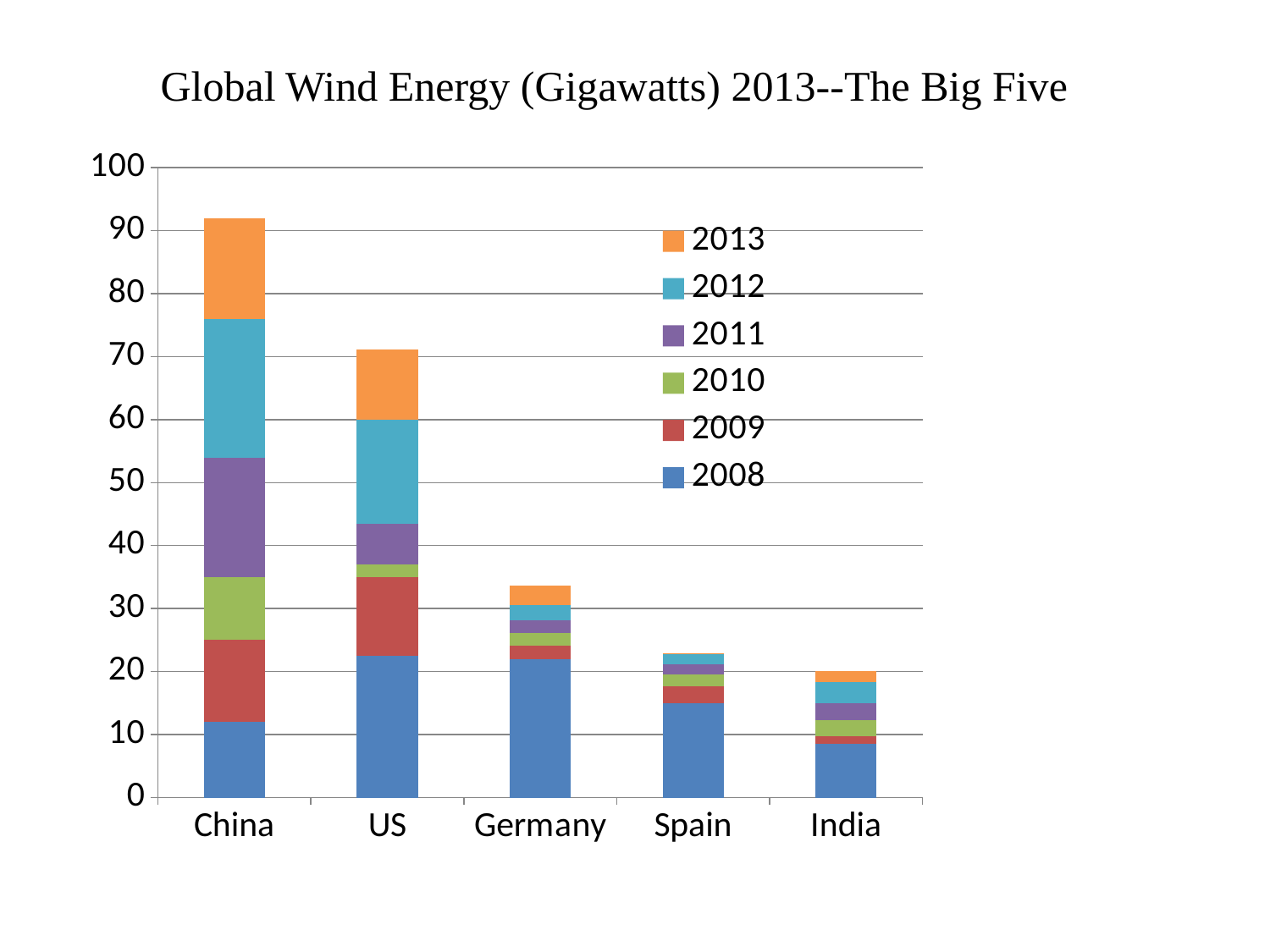
Which country has the tallest stacked bar? China How many countries are shown on the x axis of the chart? 5 What kind of chart is shown on the slide? stacked bar chart Which has the taller stacked bar, Germany or Spain? Germany Which has the taller stacked bar, China or US? China Is the total stacked bar for US greater or less than 60? greater Is the total stacked bar for Spain greater or less than 30? less How many series does the legend list? 6 What is the title of the chart? Global Wind Energy (Gigawatts) 2013--The Big Five Is the total stacked bar for Germany greater or less than 40? less Which year does the orange segment at the top of each bar represent? 2013